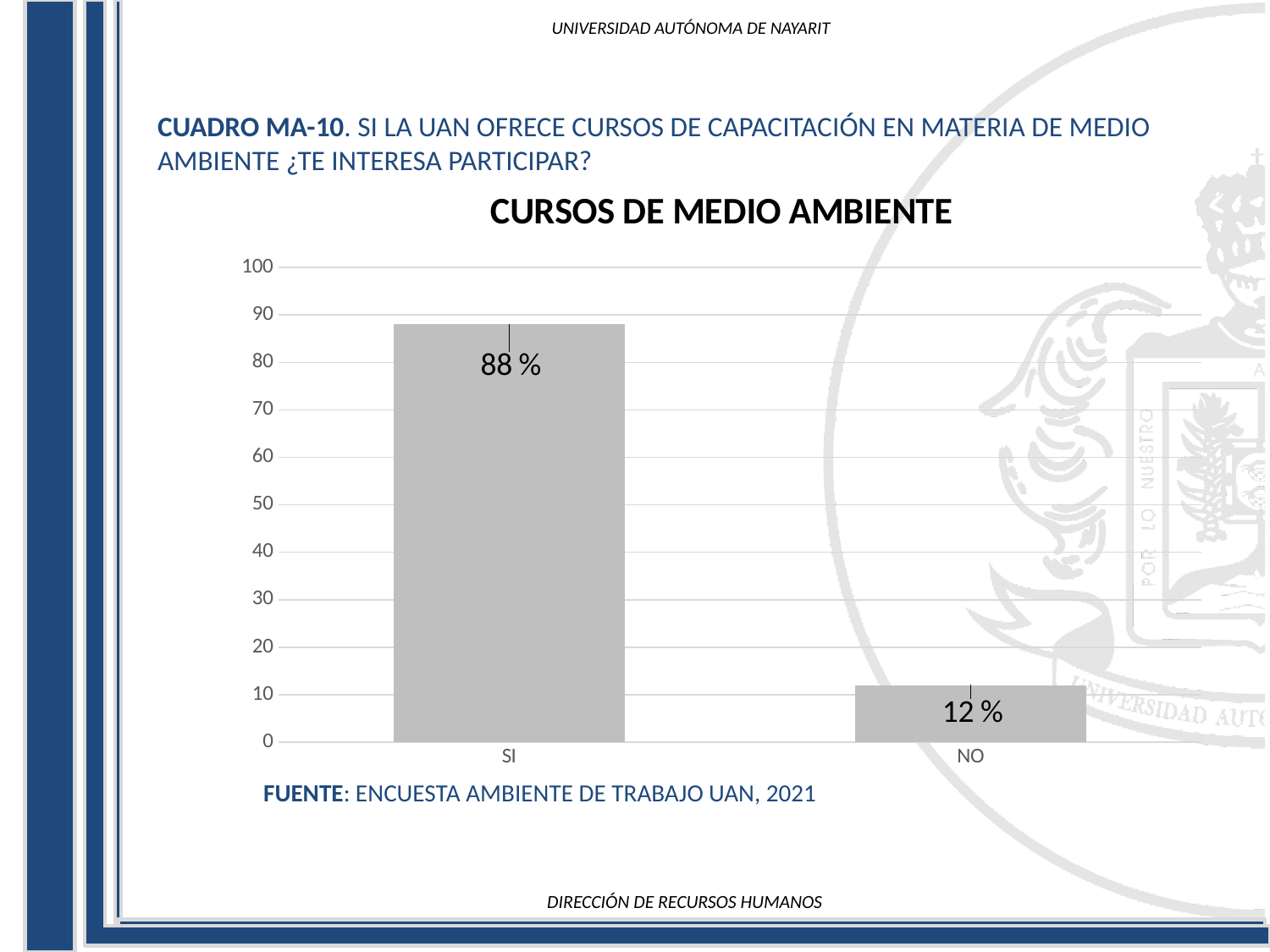
Is the value for SI greater or less than 80? greater What kind of chart is shown? bar chart How many categories are shown on the x axis? 2 What is the title of the chart? CURSOS DE MEDIO AMBIENTE What is the maximum value shown on the y axis? 100 Which category has the lowest value? NO Which is larger, the value for SI or the value for NO? SI What is the value for NO? 12 % What is the difference between the values for SI and NO? 76 % Which category has the highest value? SI What is the value for SI? 88 % Is the value for NO greater or less than 20? less